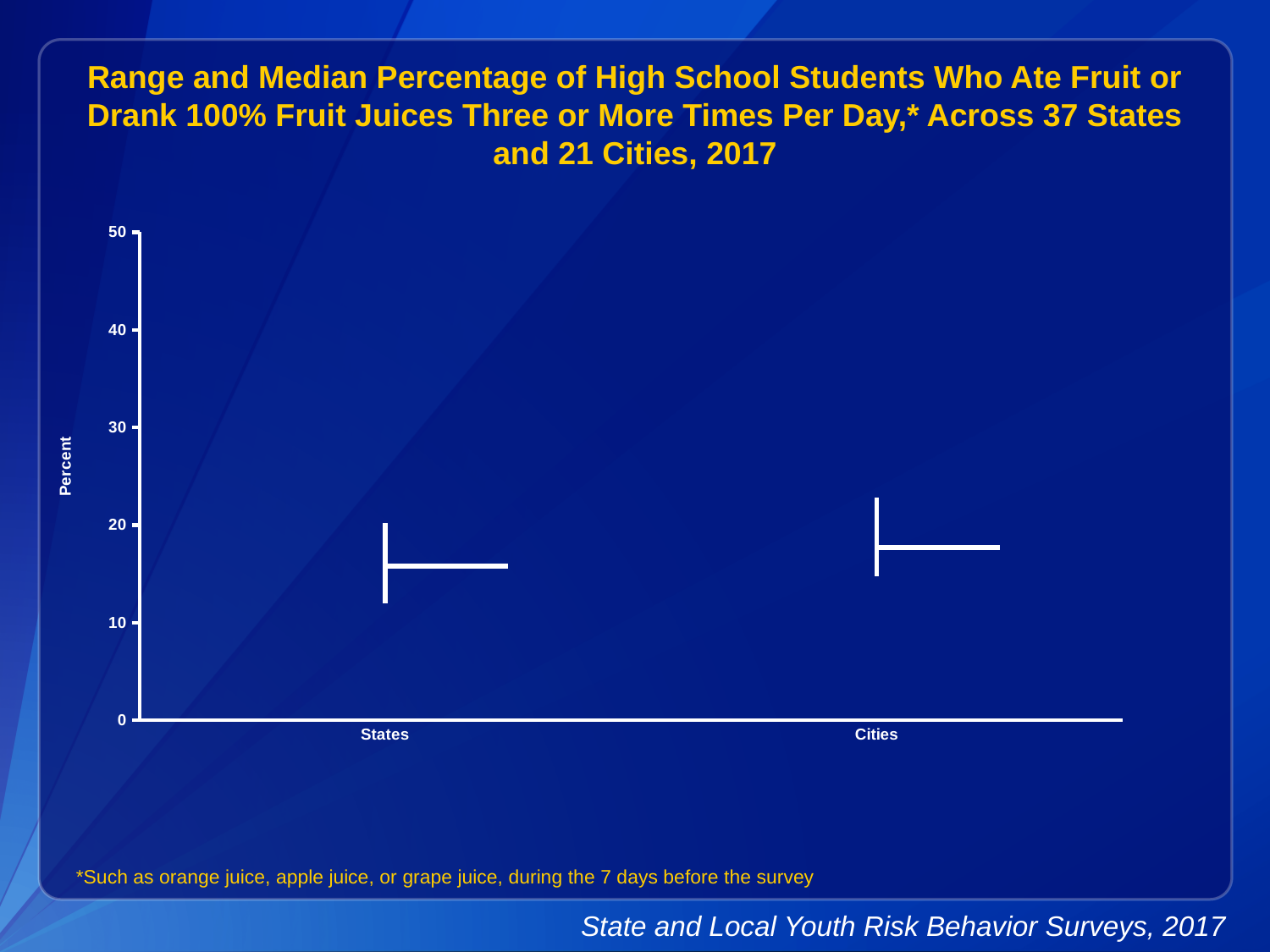
Is the median value for States greater or less than 20? less Is the median value for States greater or less than 10? greater Is the top of the range for Cities greater or less than 20? greater What is the highest value shown on the y axis? 50 What is the label of the y axis? Percent How many categories are shown on the x axis of the chart? 2 Which category has the higher top of its range, States or Cities? Cities What are the two categories shown on the x axis? States and Cities Which category has the higher median value, States or Cities? Cities